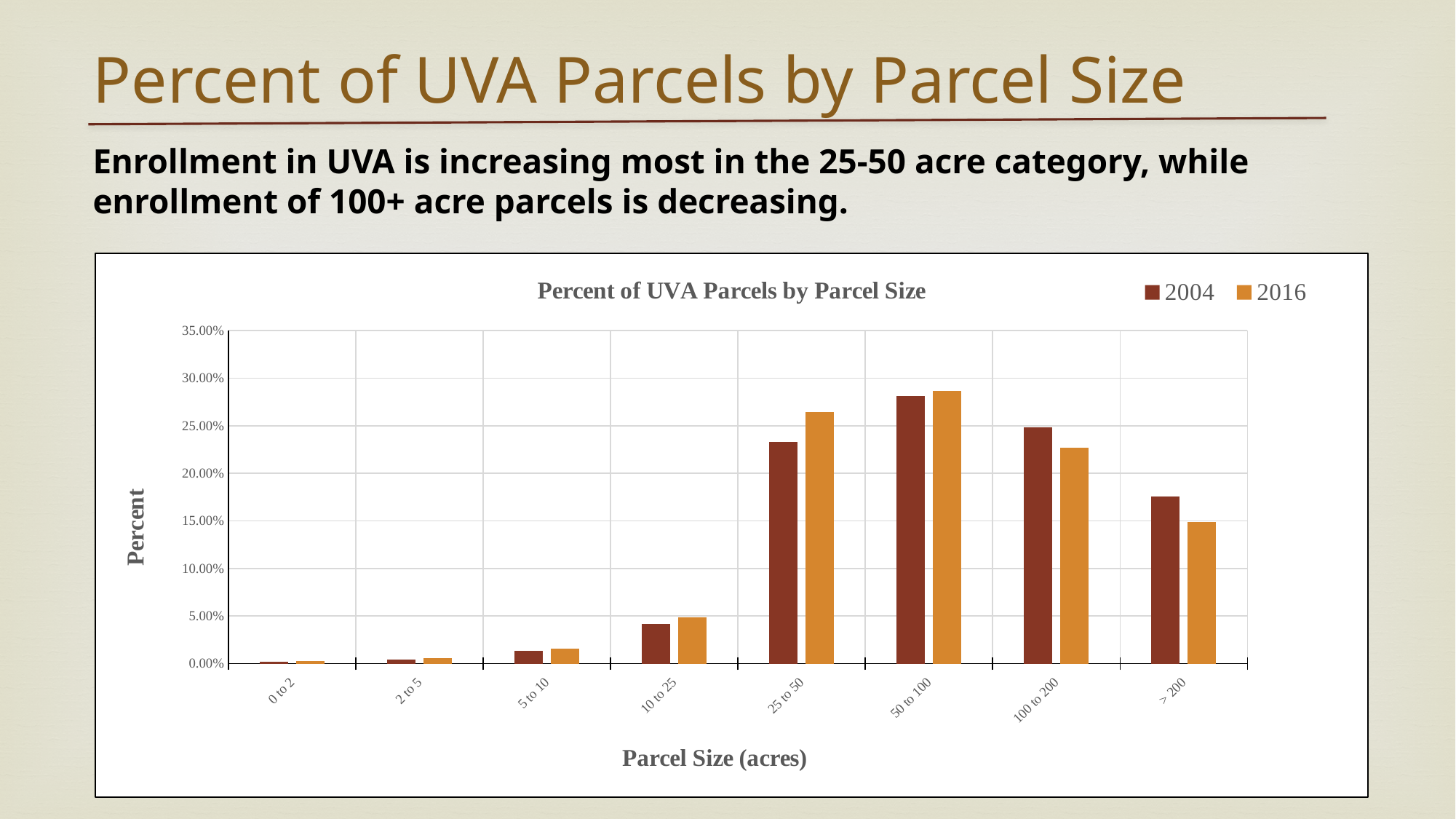
What is the label of the x axis? Parcel Size (acres) Is the 2004 value for 25 to 50 acres greater or less than 25.00%? less For the 25 to 50 acre category, which year has the larger value, 2004 or 2016? 2016 How many parcel size categories are shown on the x axis? 8 Which parcel size category has the highest value for 2016? 50 to 100 Which parcel size category has the lowest value for 2016? 0 to 2 For the > 200 acre category, which year has the larger value, 2004 or 2016? 2004 Is the 2016 value for 25 to 50 acres greater or less than 25.00%? greater What kind of chart is shown on the slide? bar chart How many series does the legend list? 2 Which parcel size category has the highest value for 2004? 50 to 100